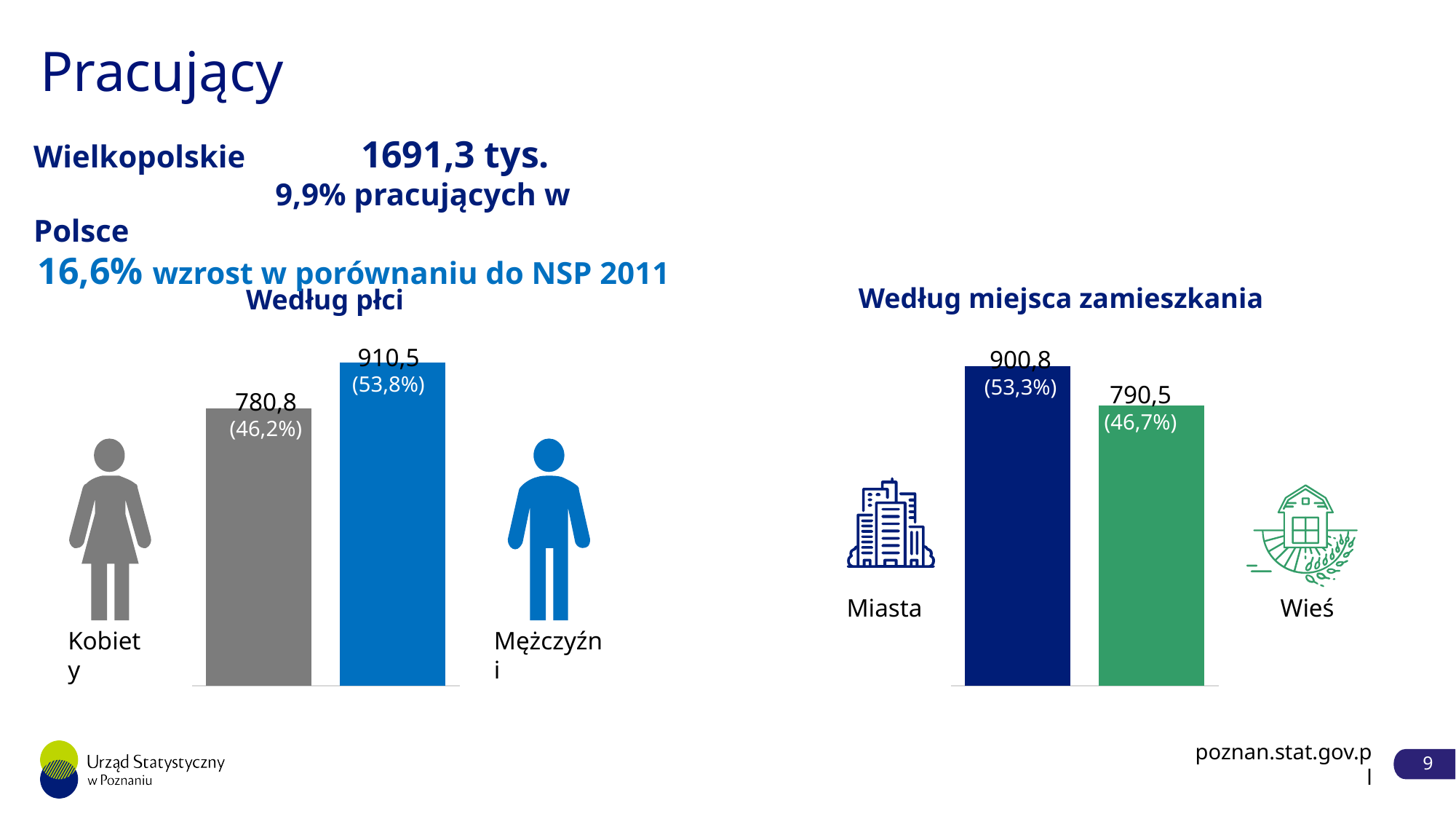
In the 'Według miejsca zamieszkania' chart, what percentage share is shown for Wieś? 46,7% In the 'Według miejsca zamieszkania' chart, what is the value for Miasta? 900,8 In the 'Według płci' chart, what is the value for Kobiety? 780,8 In the 'Według płci' chart, what is the value for Mężczyźni? 910,5 In the 'Według płci' chart, what is the total of the two bars? 1691,3 In the 'Według płci' chart, which category has the higher value? Mężczyźni In the 'Według miejsca zamieszkania' chart, which category has the lower value? Wieś What kind of chart is the 'Według miejsca zamieszkania' chart? bar chart In the 'Według miejsca zamieszkania' chart, what is the difference between the values for Miasta and Wieś? 110,3 In the 'Według płci' chart, what percentage share is shown for Mężczyźni? 53,8% In the 'Według płci' chart, what is the difference between the values for Mężczyźni and Kobiety? 129,7 In the 'Według miejsca zamieszkania' chart, what is the value for Wieś? 790,5